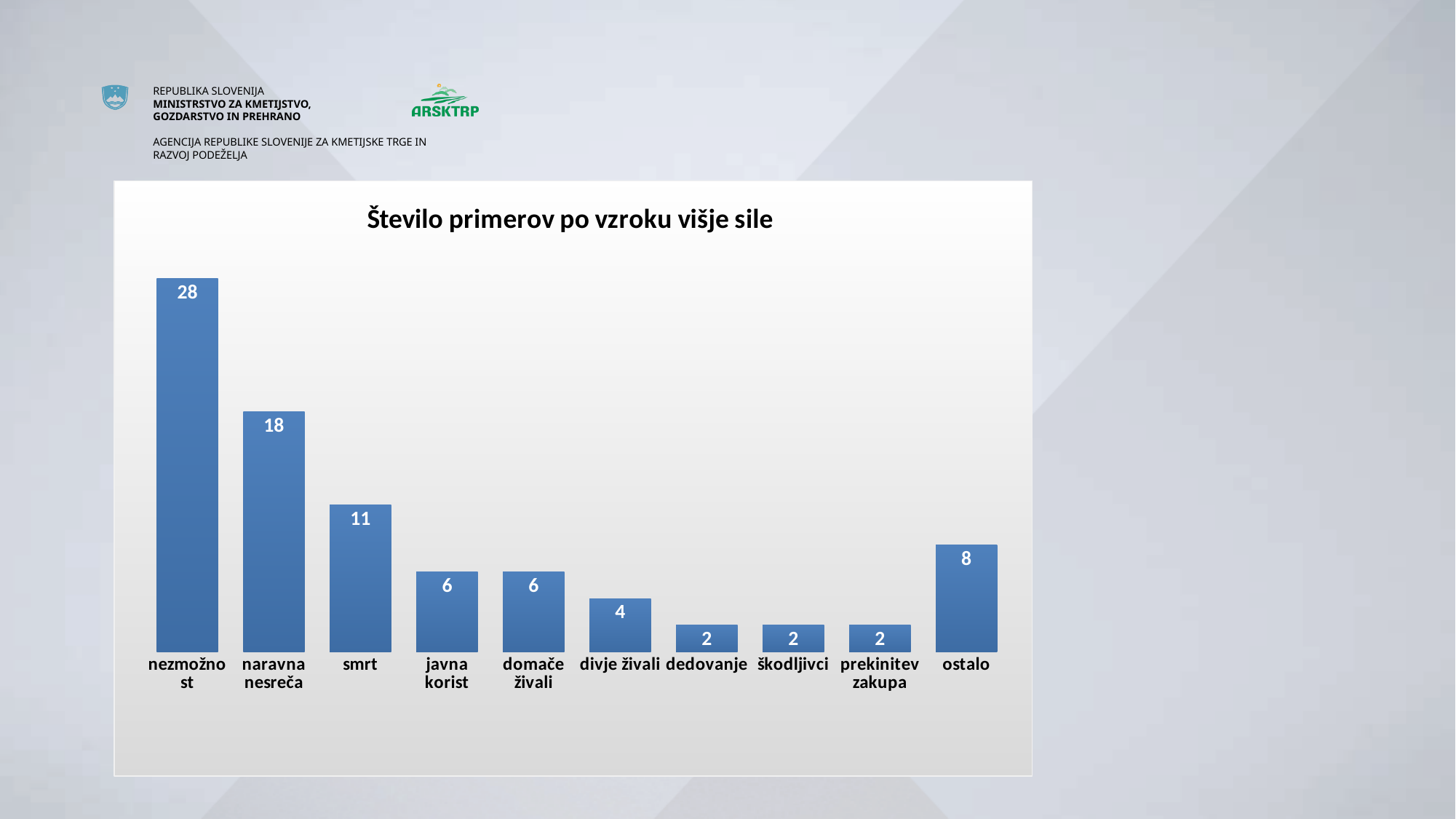
What is the difference between the values for 'nezmožnost' and 'naravna nesreča'? 10 Which category has the highest value? nezmožnost What is the value for 'ostalo'? 8 How many categories are shown in the chart? 10 What is the value for 'smrt'? 11 How many categories have a value of 2? 3 What is the value for 'nezmožnost' in the chart? 28 What kind of chart is shown on the slide? bar chart What is the difference between the values for 'smrt' and 'javna korist'? 5 What is the value for 'naravna nesreča'? 18 Which is larger, the value for 'divje živali' or the value for 'ostalo'? ostalo What is the title of the chart? Število primerov po vzroku višje sile